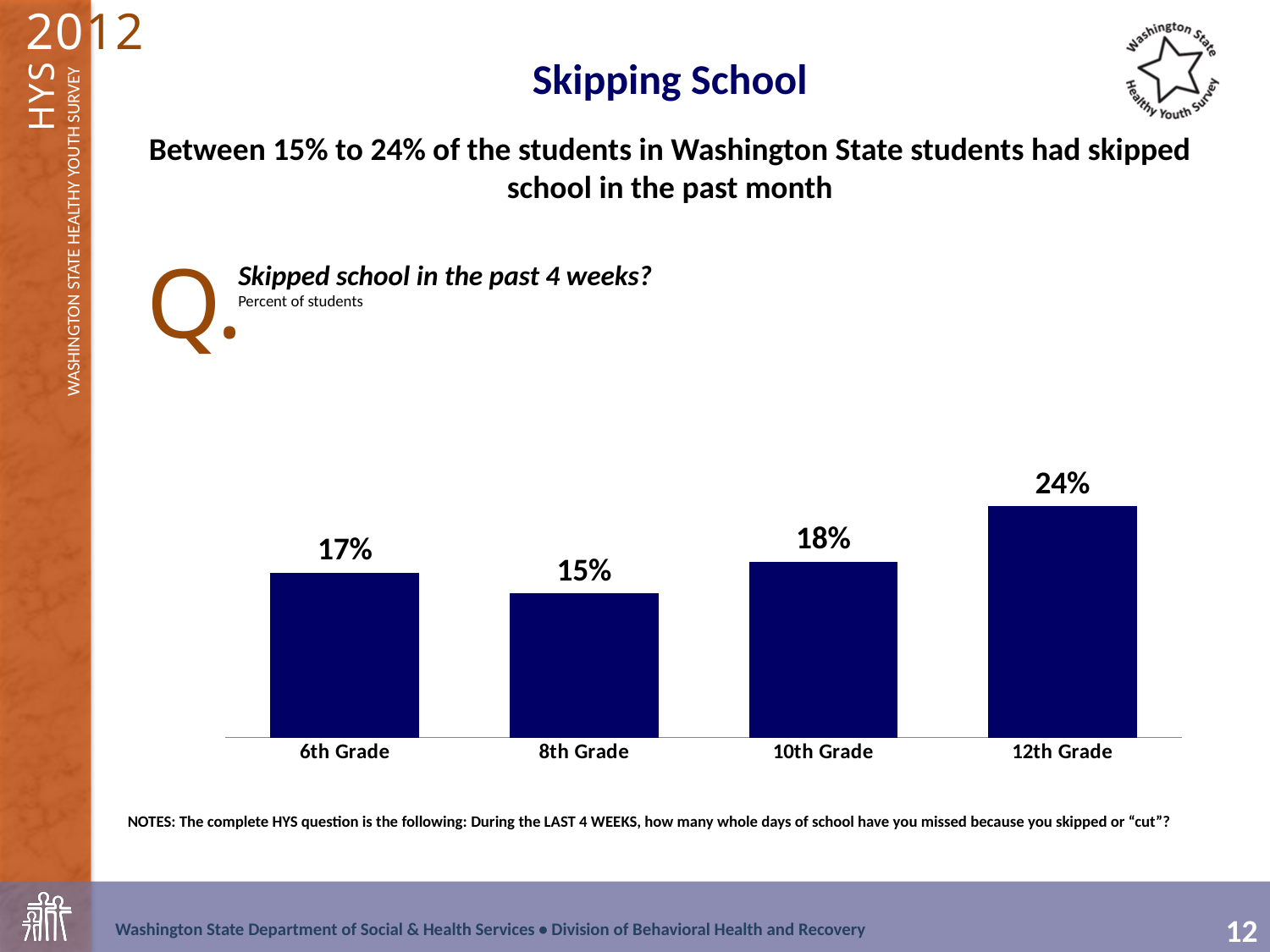
What is the question shown above the chart? Skipped school in the past 4 weeks? What is the value shown for 10th Grade? 18% Which grade has the highest percentage of students who skipped school? 12th Grade What percentage of 6th Grade students skipped school in the past 4 weeks? 17% What is the difference between the 12th Grade and 8th Grade values? 9% What is the difference between the 10th Grade and 6th Grade values? 1% How many grade categories are shown in the chart? 4 Which grade has the lowest percentage of students who skipped school? 8th Grade What is the value shown for 12th Grade? 24% What kind of chart is shown on the slide? Bar chart What is the value shown for 8th Grade? 15% Which is larger, the value for 6th Grade or the value for 8th Grade? 6th Grade